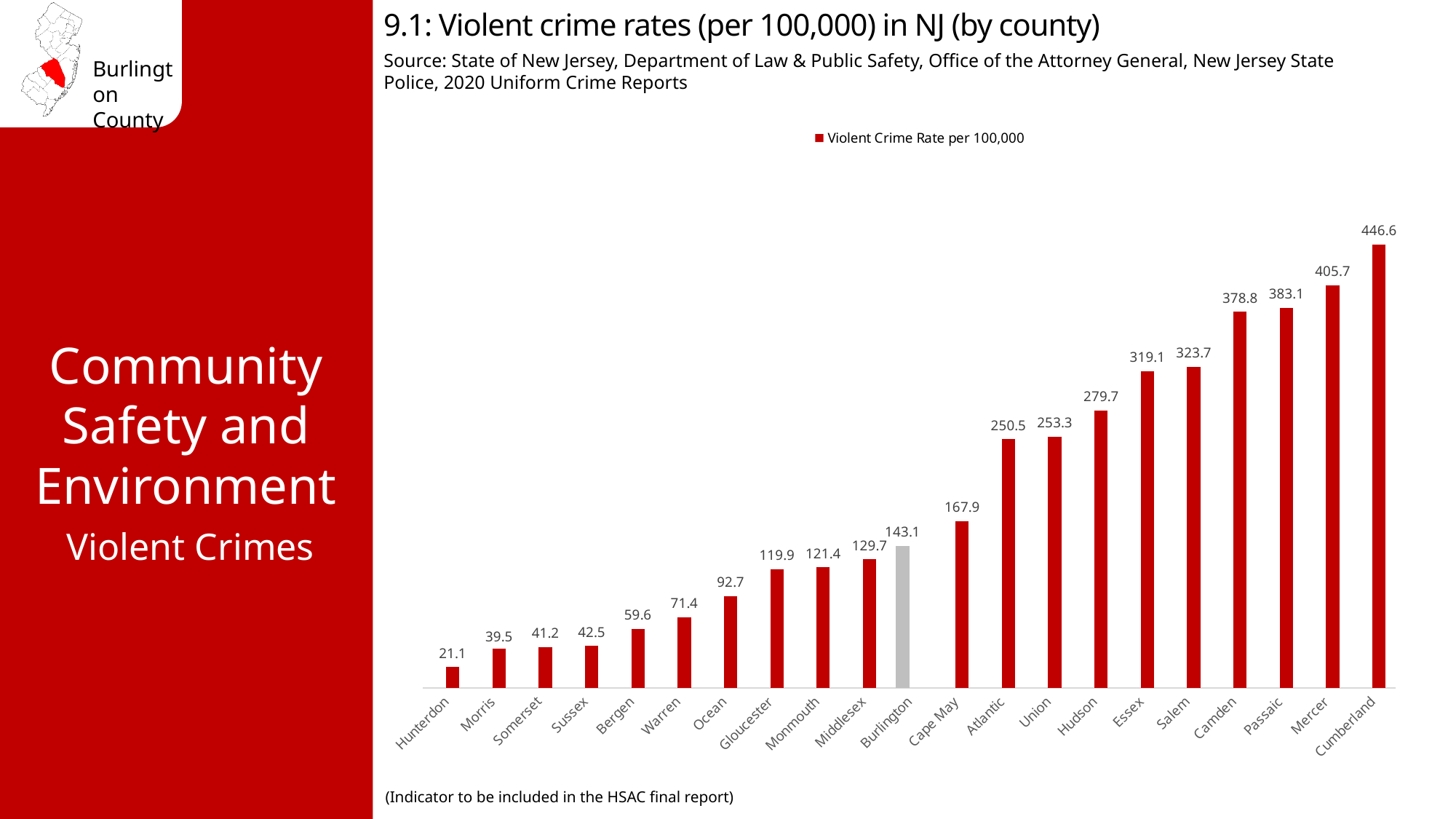
What is the difference between the violent crime rates of Cape May and Burlington? 24.8 What is the violent crime rate per 100,000 for Ocean County? 92.7 How many counties are shown in the chart? 21 What is the violent crime rate per 100,000 for Burlington County? 143.1 Which county has a higher violent crime rate, Essex or Atlantic? Essex Which county has the highest violent crime rate? Cumberland Which county has the lowest violent crime rate? Hunterdon How many series does the legend list? 1 Do the violent crime rates rise or fall from left to right across the counties? Rise What type of chart is shown on the slide? Bar chart What is the difference between the violent crime rates of Cumberland and Hunterdon? 425.5 What is the violent crime rate per 100,000 for Hudson County? 279.7